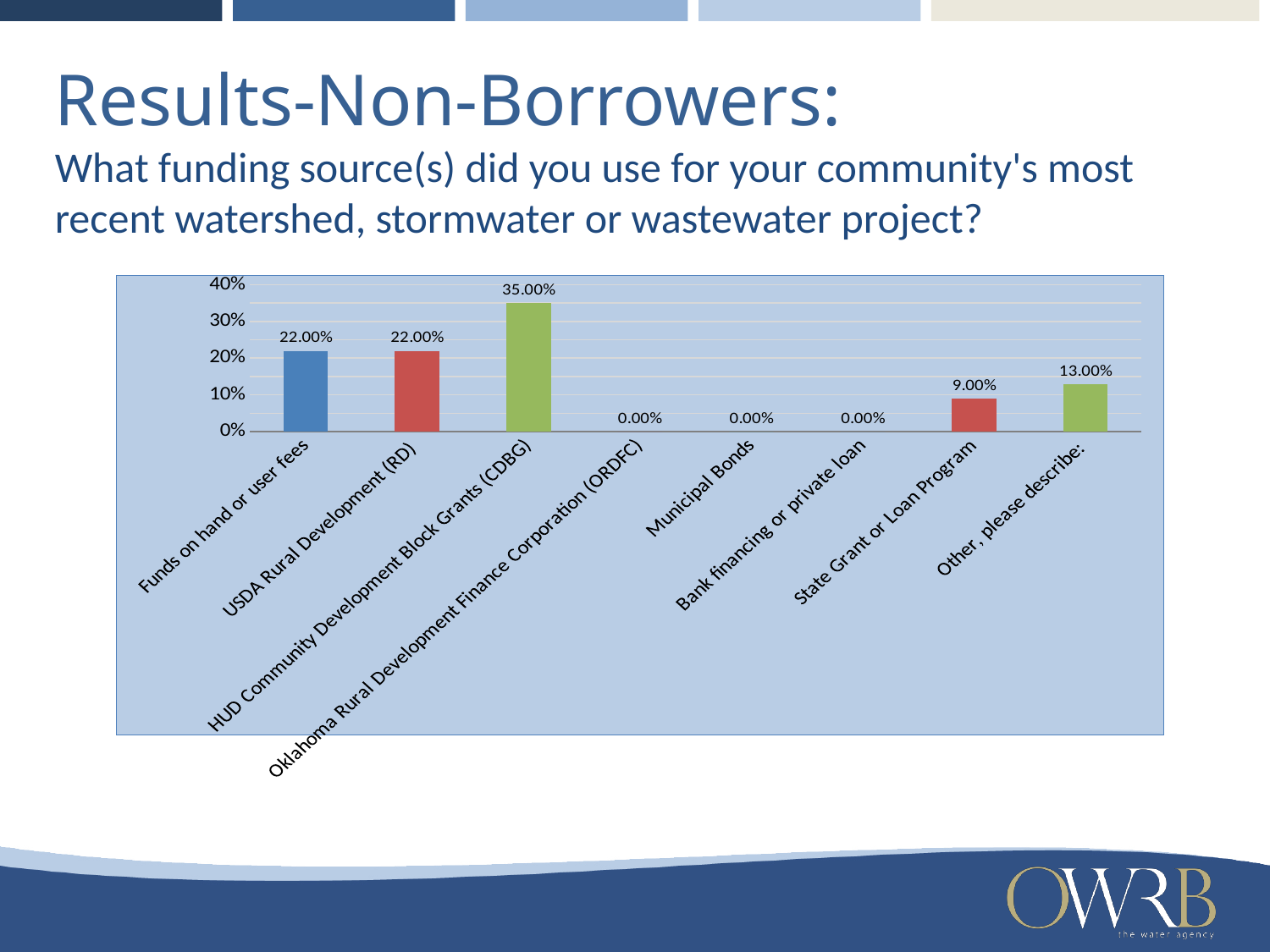
Which is larger, the value for USDA Rural Development (RD) or the value for State Grant or Loan Program? USDA Rural Development (RD) How many categories have a value of 0.00%? 3 What is the value for Municipal Bonds? 0.00% What is the value for State Grant or Loan Program? 9.00% What is the difference between the values for HUD Community Development Block Grants (CDBG) and Funds on hand or user fees? 13.00% Is the value for HUD Community Development Block Grants (CDBG) greater or less than 30%? greater What is the value for HUD Community Development Block Grants (CDBG)? 35.00% What kind of chart is shown on the slide? bar chart What is the value for Other, please describe:? 13.00% How many funding source categories are shown on the x axis? 8 Which funding source has the highest value? HUD Community Development Block Grants (CDBG) What is the difference between the values for Other, please describe: and State Grant or Loan Program? 4.00%